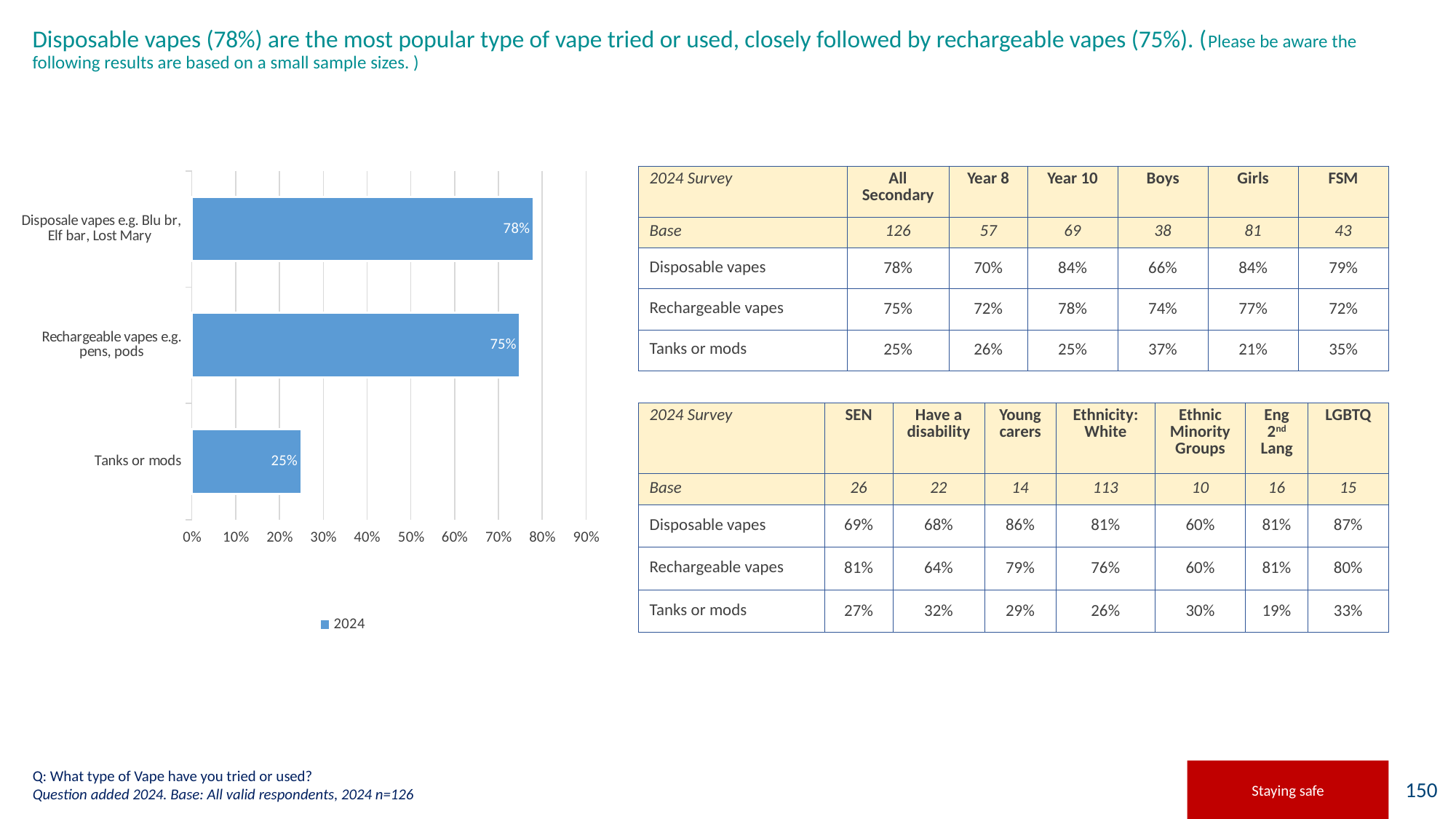
What kind of chart is shown on the slide? Bar chart Which category has the highest value in the bar chart? Disposable vapes e.g. Blu br, Elf bar, Lost Mary How many categories are shown in the bar chart? 3 Which is larger in the bar chart: the value for Rechargeable vapes or the value for Tanks or mods? Rechargeable vapes What is the value for Tanks or mods in the bar chart? 25% What is the difference between the values for Disposable vapes and Rechargeable vapes in the bar chart? 3% Is the value for Tanks or mods in the bar chart greater or less than 30%? less What is the value for Rechargeable vapes e.g. pens, pods in the bar chart? 75% How many series does the legend of the bar chart list? 1 Which category has the lowest value in the bar chart? Tanks or mods What is the value for Disposable vapes e.g. Blu br, Elf bar, Lost Mary in the bar chart? 78% What is the difference between the values for Disposable vapes and Tanks or mods in the bar chart? 53%